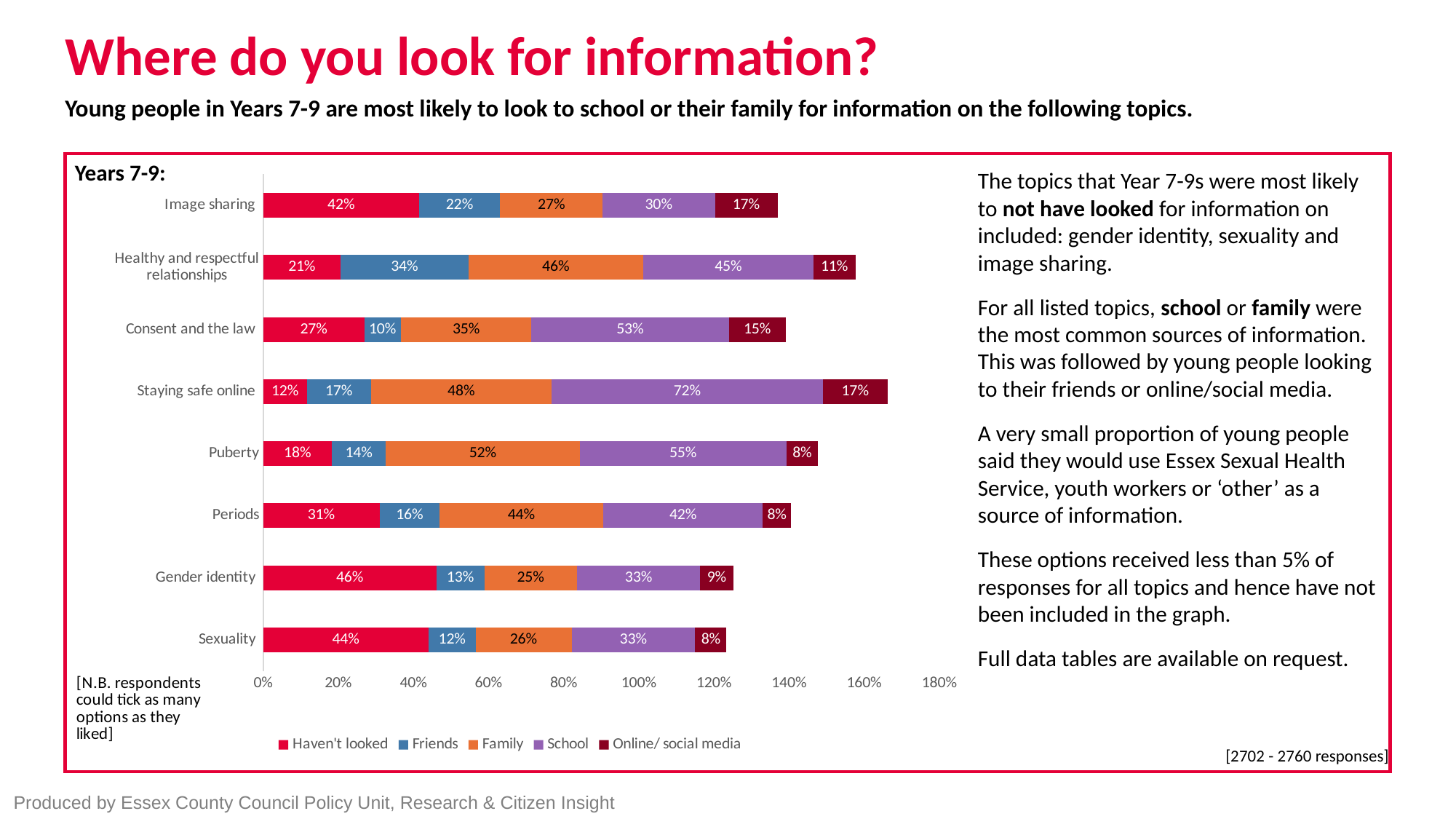
Which topic has the lowest School percentage? Image sharing Which series is shown in purple in the legend? School What type of chart is shown on the slide? Stacked bar chart How many series does the legend list? 5 Is the Family value larger for Periods or for Sexuality? Periods What is the total of the stacked bar for Staying safe online? 166% What percentage of Year 7-9 respondents said they look to School for information on Staying safe online? 72% How many topics are shown on the chart? 8 Which topic has the highest Haven't looked percentage? Gender identity What percentage look to Family for information on Puberty? 52% What is the difference between the Friends value for Healthy and respectful relationships and the Friends value for Consent and the law? 24% What is the Haven't looked value for Gender identity? 46%